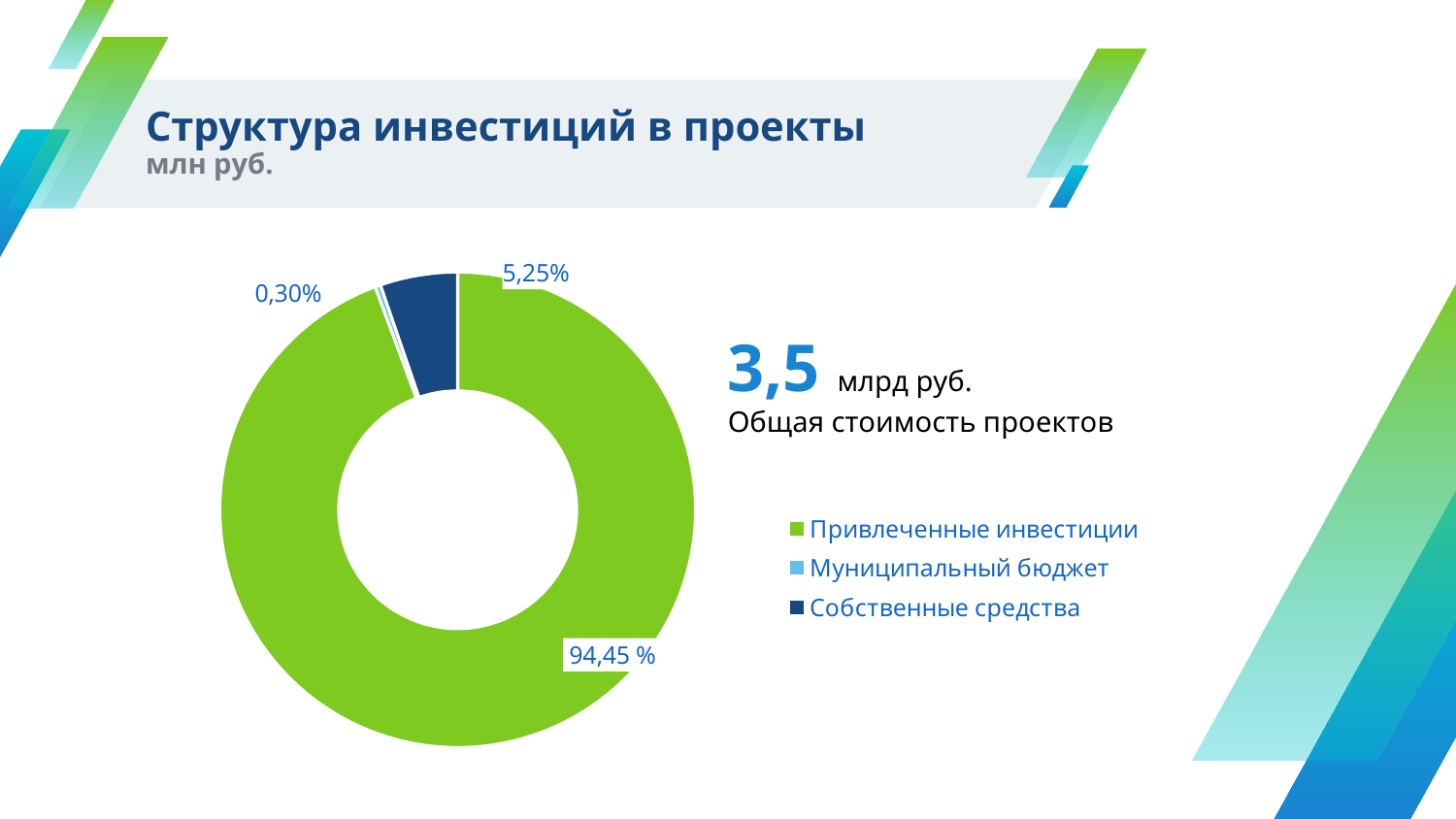
How many entries does the legend list? 3 What is the title of the chart on the slide? Структура инвестиций в проекты Which legend entry is shown in dark blue? Собственные средства What share of the pie does Собственные средства have? 5,25% What share of the pie does Муниципальный бюджет have? 0,30% Which is larger: the share for Собственные средства or the share for Муниципальный бюджет? Собственные средства What share of the pie does Привлеченные инвестиции have? 94,45 % What is the difference in percentage points between the share for Собственные средства and the share for Муниципальный бюджет? 4,95 What kind of chart is shown on the slide? Pie chart (donut) How many slices does the pie chart have? 3 Which category has the largest slice of the pie? Привлеченные инвестиции Which category has the smallest slice of the pie? Муниципальный бюджет